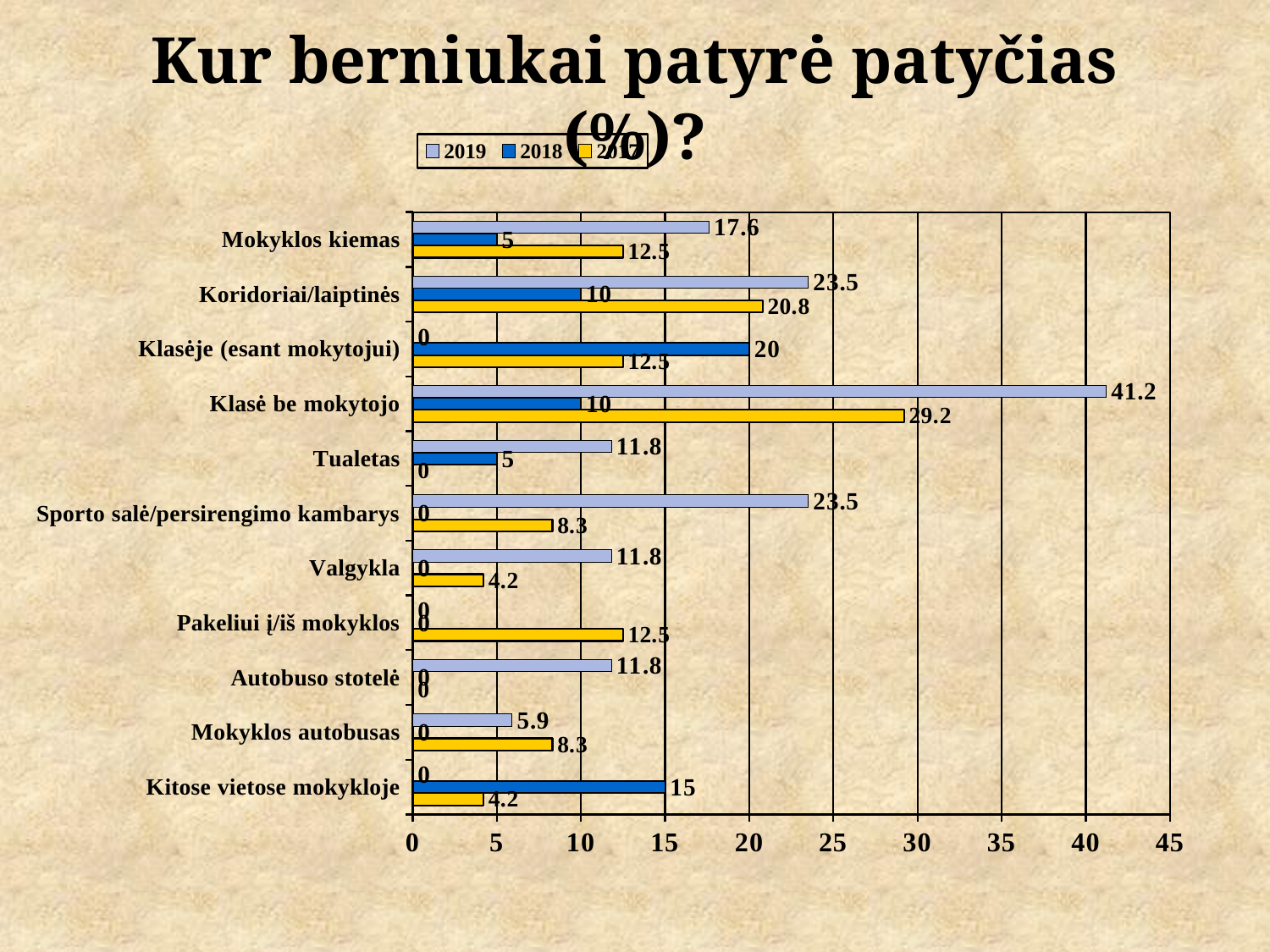
For Mokyklos kiemas, which is larger: the 2019 value or the 2017 value? 2019 What is the 2019 value for Klasė be mokytojo? 41.2 Which series is shown in yellow in the legend? 2017 How many series does the legend list? 3 Which category has the highest 2017 value? Klasė be mokytojo What is the difference between the 2019 and 2017 values for Klasė be mokytojo? 12 How many categories (locations) are shown on the chart? 11 Which category has the highest 2019 value? Klasė be mokytojo What is the 2017 value for Koridoriai/laiptinės? 20.8 What is the 2018 value for Kitose vietose mokykloje? 15 What kind of chart is shown on the slide? bar chart What is the difference between the 2018 and 2017 values for Klasėje (esant mokytojui)? 7.5